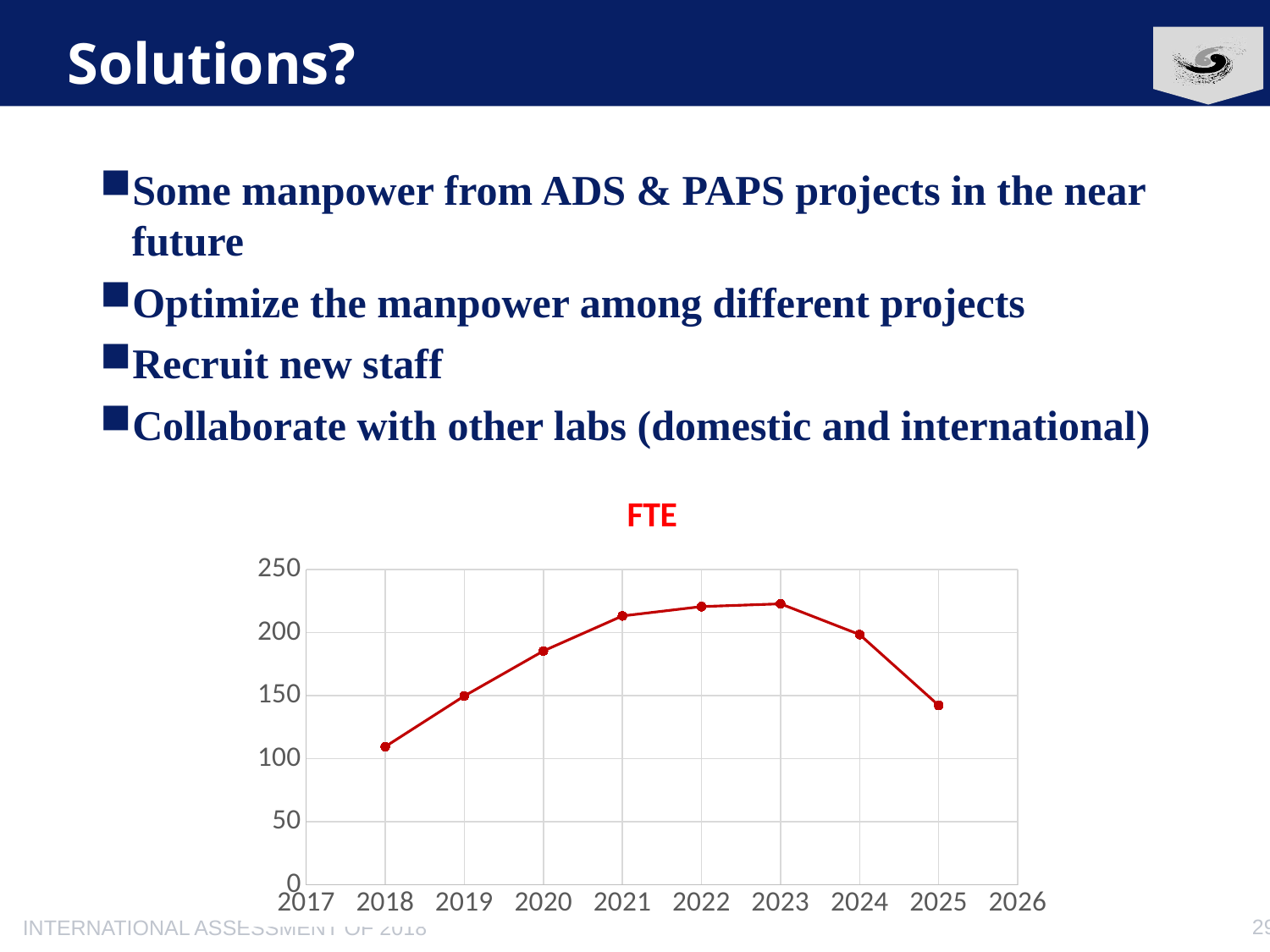
Which year has the lowest FTE value? 2018 Which year has the larger FTE value, 2018 or 2025? 2025 How many data points are plotted on the line? 8 Do the FTE values rise or fall from 2023 to 2025? fall Do the FTE values rise or fall from 2018 to 2023? rise Is the FTE value for 2021 greater or less than 200? greater What kind of chart is shown on the slide? line chart Is the FTE value for 2018 greater or less than 150? less Is the FTE value for 2025 greater or less than 150? less Which year has the larger FTE value, 2020 or 2024? 2024 What is the title of the chart? FTE